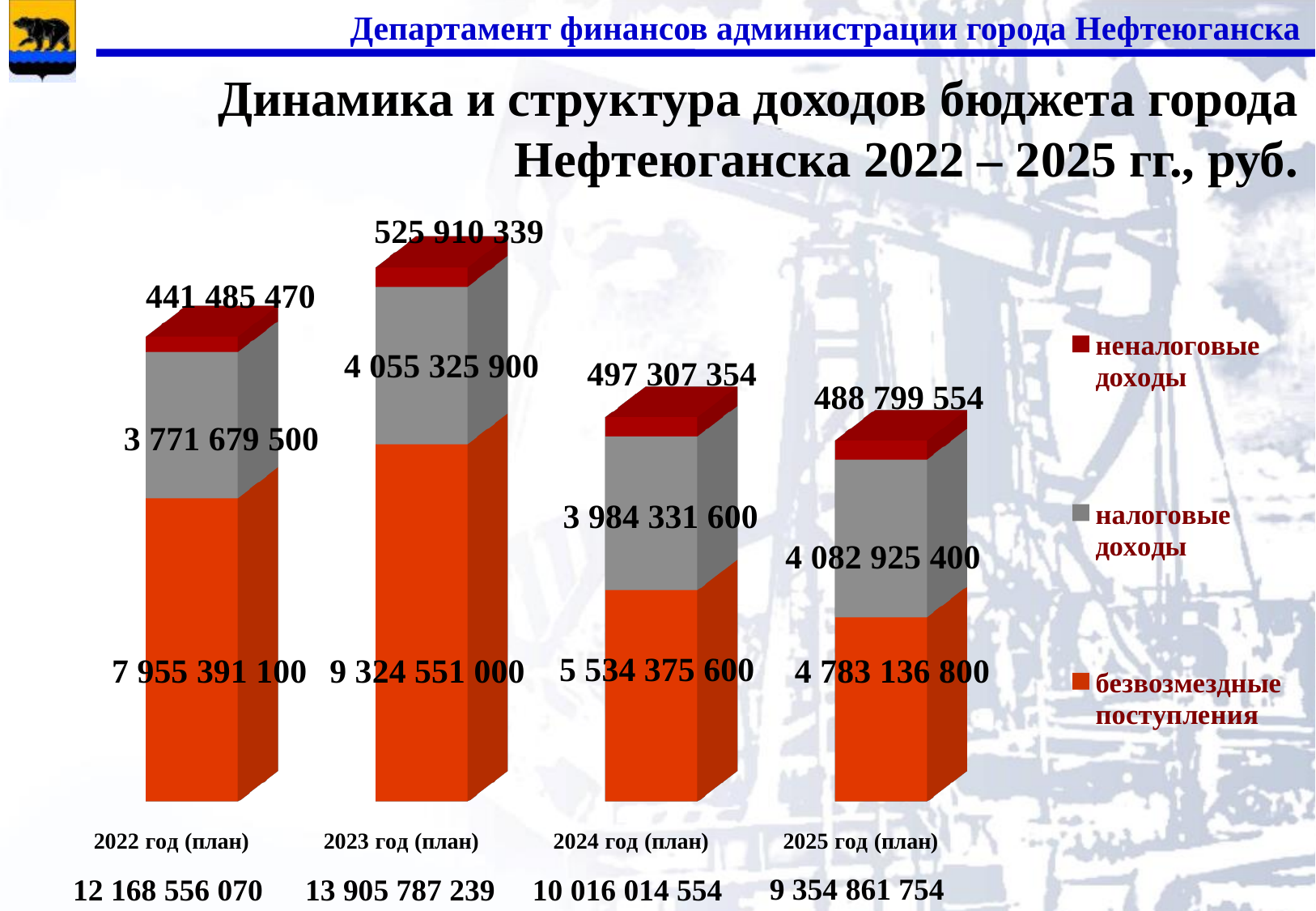
What kind of chart is shown on the slide? Stacked bar chart In which year is the value of неналоговые доходы the lowest? 2022 год (план) How many series does the legend list? 3 Which is larger: налоговые доходы in 2023 год (план) or in 2024 год (план)? 2023 год (план) What is the total of the stacked bar for 2024 год (план)? 10 016 014 554 What is the value of налоговые доходы for 2025 год (план)? 4 082 925 400 What is the difference between безвозмездные поступления in 2023 год (план) and 2022 год (план)? 1 369 159 900 What is the value of безвозмездные поступления for 2022 год (план)? 7 955 391 100 What is the difference between налоговые доходы in 2025 год (план) and 2024 год (план)? 98 593 800 How many years (categories) are shown on the chart? 4 In which year is the value of безвозмездные поступления the highest? 2023 год (план) What is the value of неналоговые доходы for 2024 год (план)? 497 307 354